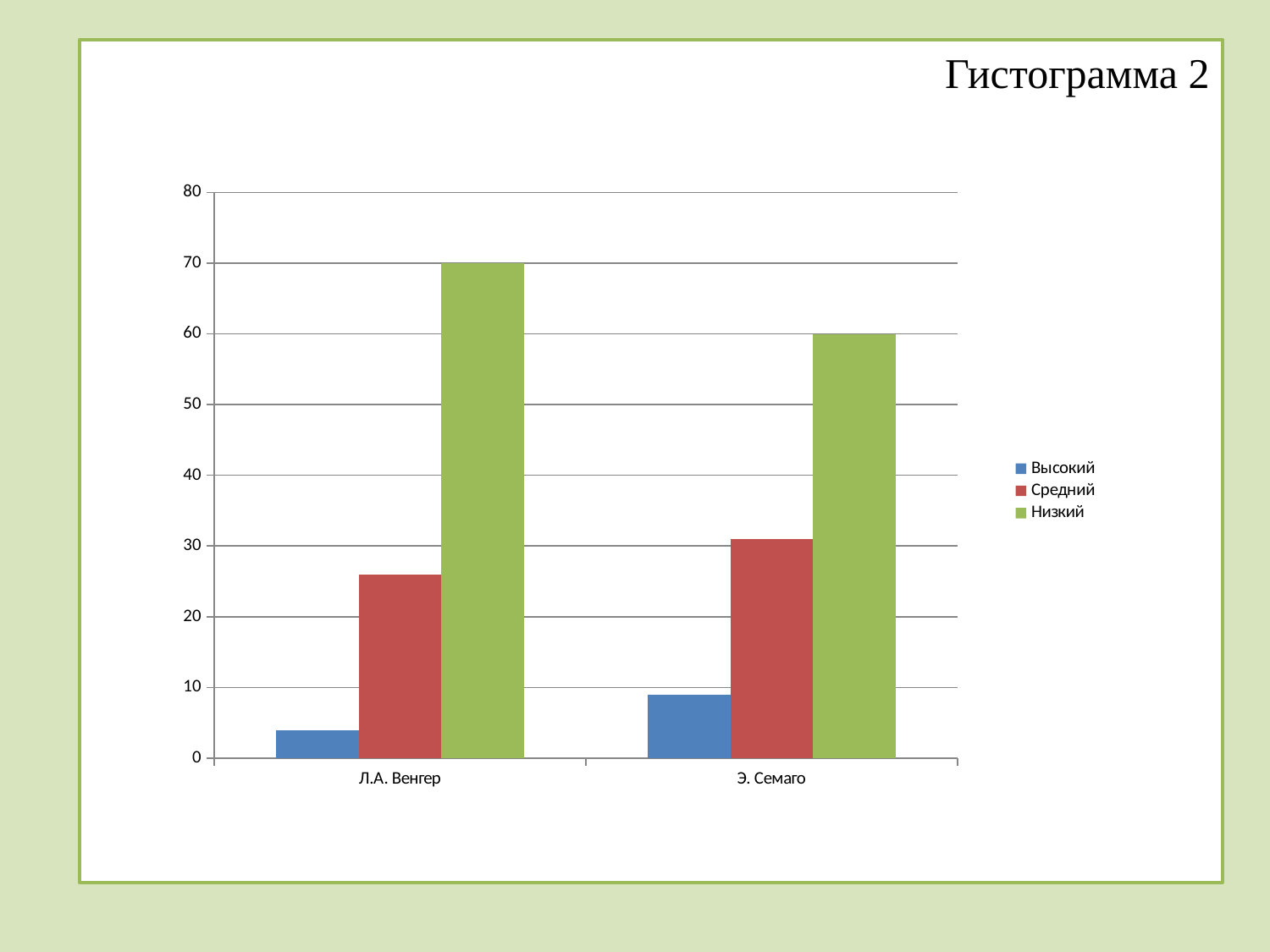
How many categories are shown on the x axis? 2 What is the value of Низкий for Э. Семаго? 60 Which series has the highest value for Л.А. Венгер? Низкий Is the value of Высокий for Л.А. Венгер greater or less than 10? less How many series does the legend list? 3 What kind of chart is shown on the slide? bar chart What is the difference between the Низкий values for Л.А. Венгер and Э. Семаго? 10 Which is larger: the Средний value for Л.А. Венгер or the Средний value for Э. Семаго? Э. Семаго What is the title of the slide? Гистограмма 2 What is the value of Низкий for Л.А. Венгер? 70 Which series has the lowest value for Э. Семаго? Высокий